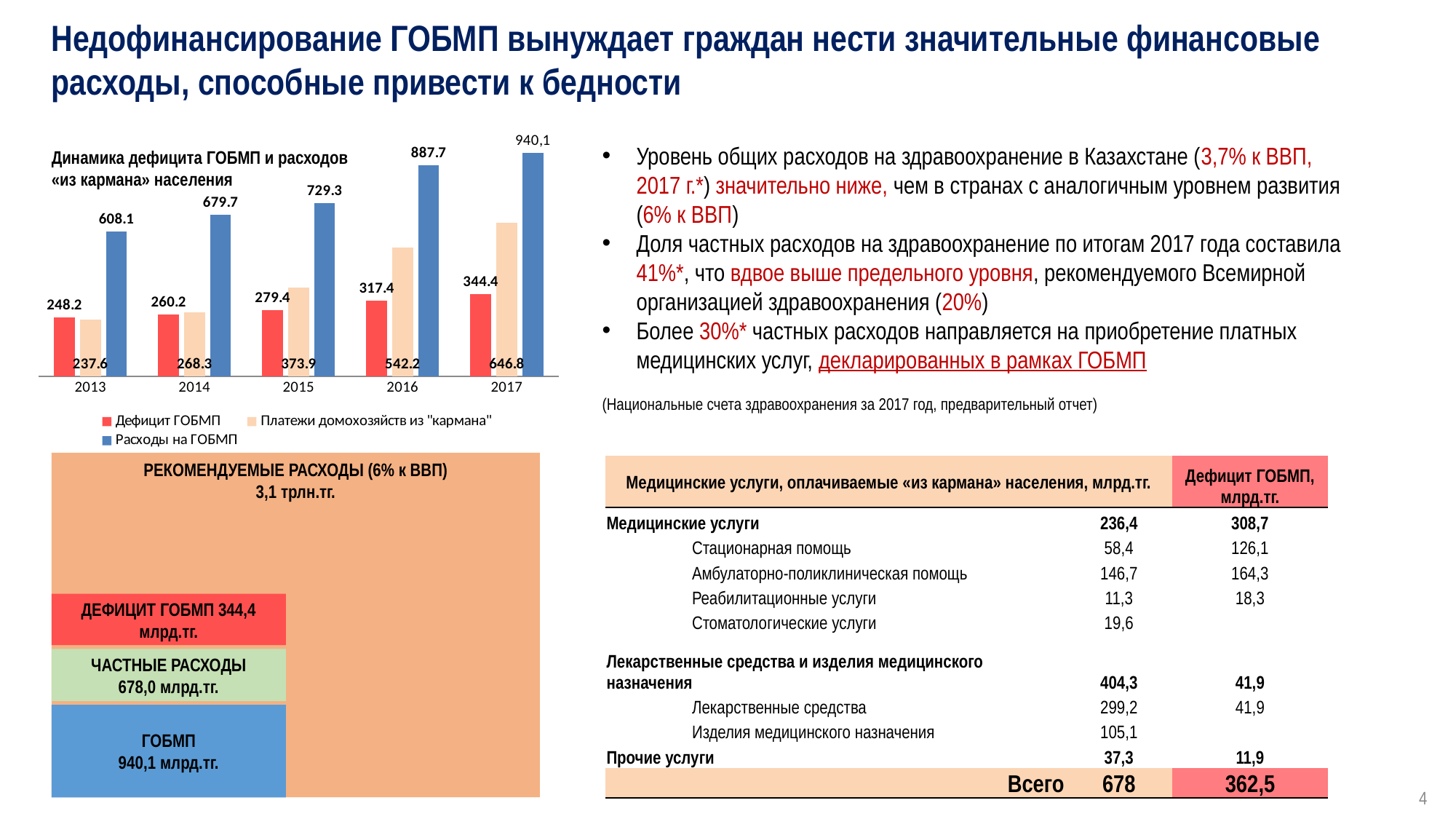
In which year is Расходы на ГОБМП the lowest? 2013 What kind of chart is shown on the slide? bar chart Do the values of Платежи домохозяйств из "кармана" rise or fall from 2013 to 2017? rise How many years are shown on the x axis of the chart? 5 In which year is Платежи домохозяйств из "кармана" the highest? 2017 What is the difference between Платежи домохозяйств из "кармана" in 2017 and in 2016? 104.6 In 2013, which is larger: Дефицит ГОБМП or Платежи домохозяйств из "кармана"? Дефицит ГОБМП How many series does the chart's legend list? 3 What is the value of Дефицит ГОБМП for 2015? 279.4 What is the value of Расходы на ГОБМП for 2017? 940,1 What is the value of Платежи домохозяйств из "кармана" for 2016? 542.2 What is the difference between Дефицит ГОБМП in 2017 and in 2013? 96.2